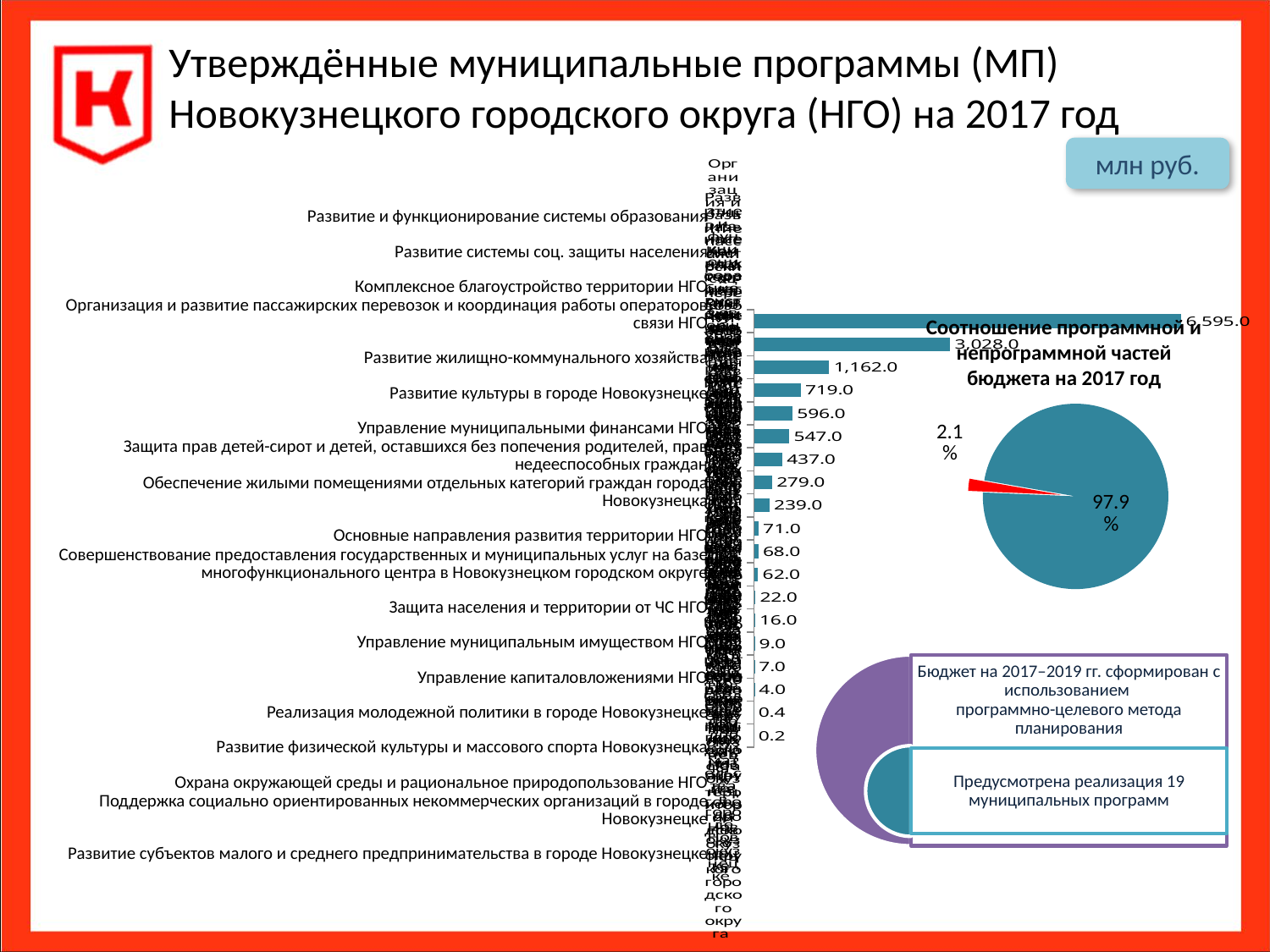
In the pie chart 'Соотношение программной и непрограммной частей бюджета на 2017 год', what share does the smaller (red) slice have? 2.1% In the bar chart on the left, which is larger: the bar labelled 719.0 or the bar labelled 596.0? 719.0 What kind of chart is 'Соотношение программной и непрограммной частей бюджета на 2017 год'? pie chart How many bars are plotted in the bar chart on the left? 19 In the bar chart on the left, what is the lowest value shown? 0.2 How many slices does the pie chart 'Соотношение программной и непрограммной частей бюджета на 2017 год' have? 2 In the bar chart on the left, what is the highest value shown? 6,595.0 In the pie chart 'Соотношение программной и непрограммной частей бюджета на 2017 год', what share does the larger slice have? 97.9% In the bar chart on the left, what is the difference between the two largest values, 6,595.0 and 3,028.0? 3,567.0 In the bar chart on the left, what is the second-highest value shown? 3,028.0 What kind of chart is the large chart on the left of the slide? bar chart What unit is shown for the values on the slide? млн руб.